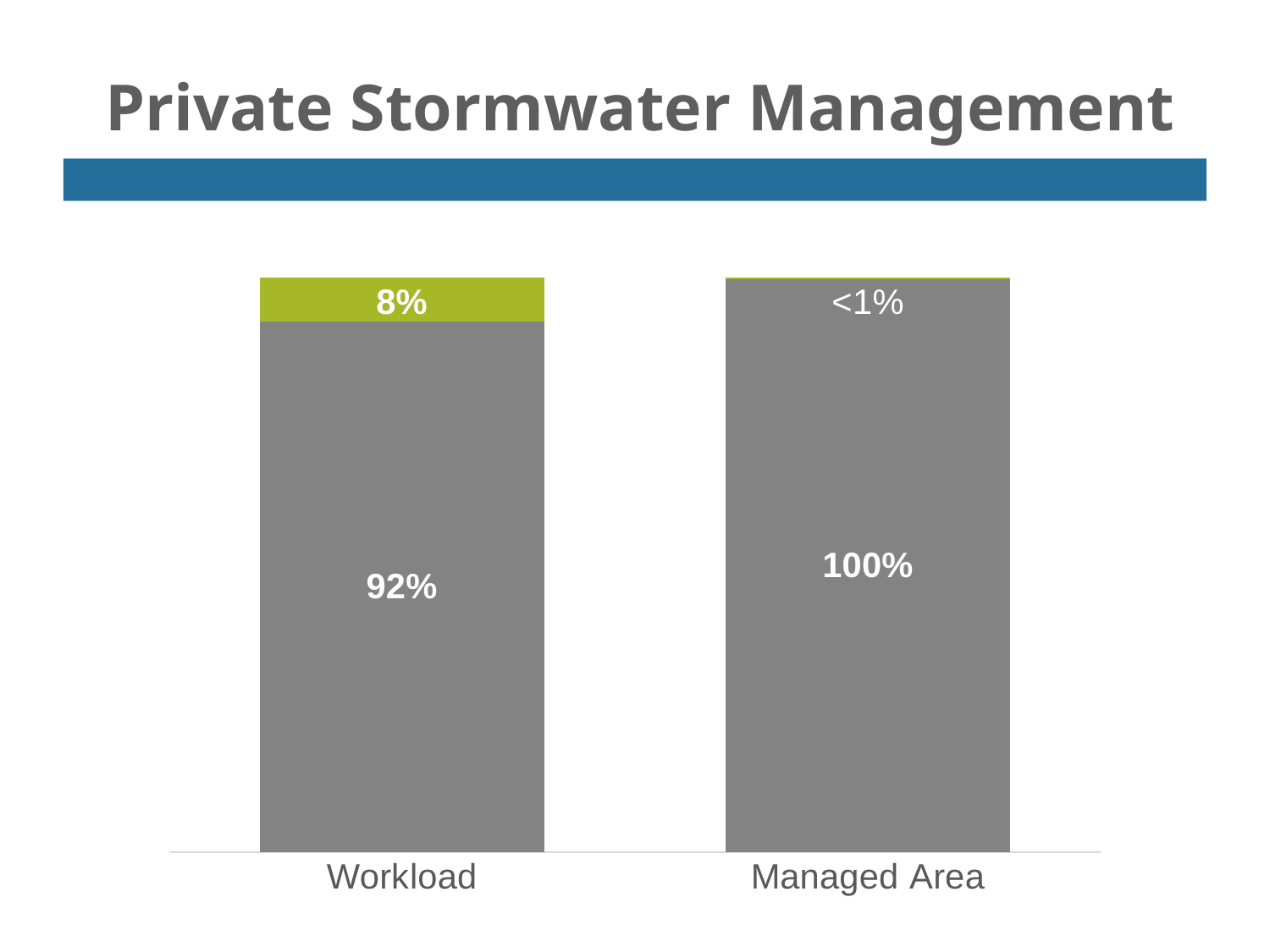
What is the total of the Workload stacked bar? 100% What is the value of the green segment for Workload? 8% What is the value of the grey segment for Managed Area? 100% What kind of chart is shown on the slide? Stacked bar chart What is the title of the slide? Private Stormwater Management What is the difference between the grey segment for Managed Area and the grey segment for Workload? 8% What label is shown for the green segment of the Managed Area bar? <1% What colour is the top segment of the Workload bar? Green How many categories are shown on the x axis? 2 What is the value of the grey segment for Workload? 92% Which category has the larger grey segment, Workload or Managed Area? Managed Area Which category has the larger green segment, Workload or Managed Area? Workload